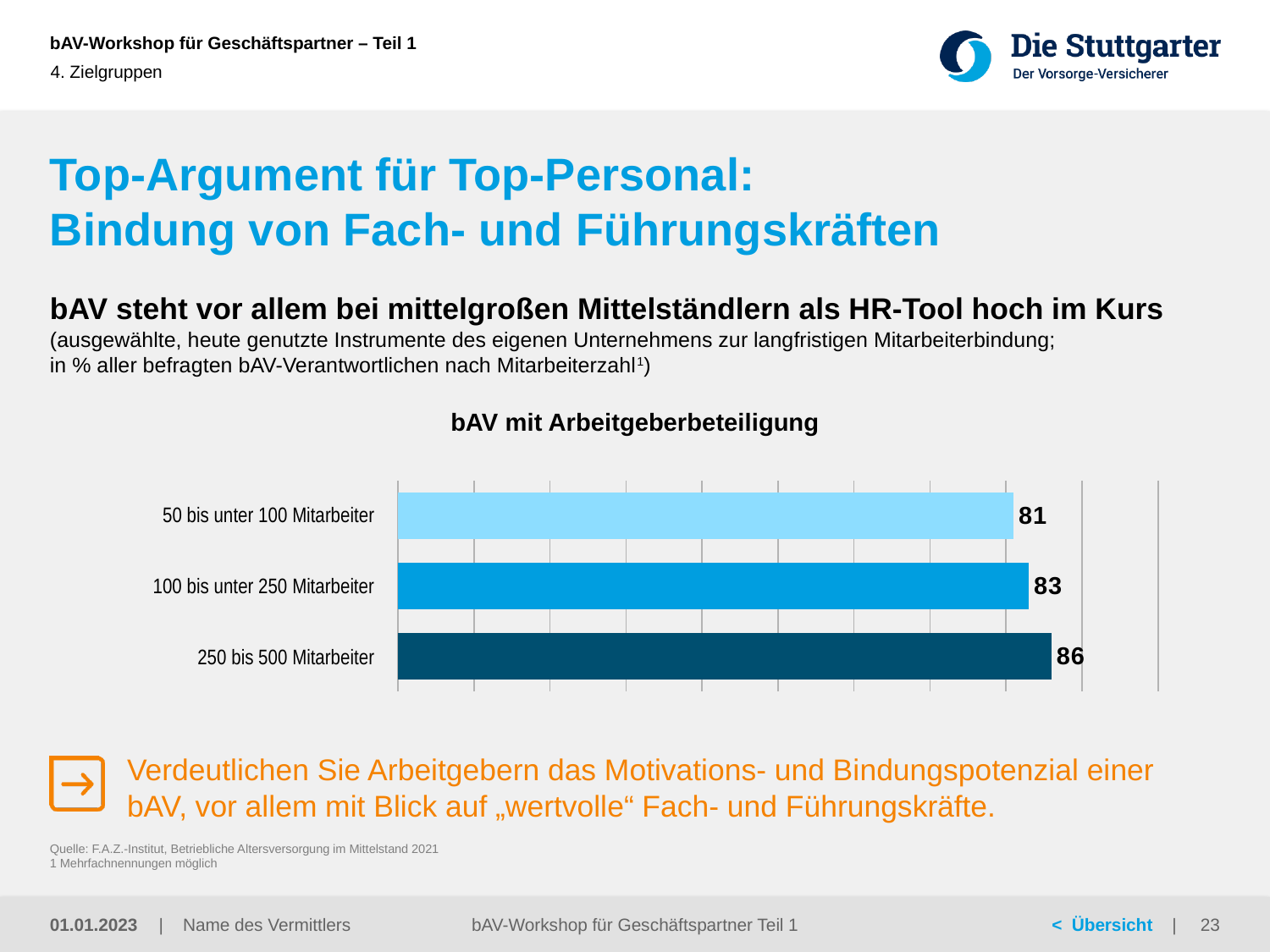
What is the difference between the values for "250 bis 500 Mitarbeiter" and "50 bis unter 100 Mitarbeiter"? 5 Which category has the highest value? 250 bis 500 Mitarbeiter What is the title of the chart? bAV mit Arbeitgeberbeteiligung What is the value for "250 bis 500 Mitarbeiter"? 86 How many categories are shown in the chart? 3 Which is larger: the value for "100 bis unter 250 Mitarbeiter" or for "250 bis 500 Mitarbeiter"? 250 bis 500 Mitarbeiter What is the value for "50 bis unter 100 Mitarbeiter"? 81 What is the value for "100 bis unter 250 Mitarbeiter"? 83 Do the values rise or fall as the company size category increases from top to bottom? Rise What kind of chart is shown on the slide? Bar chart Which category has the lowest value? 50 bis unter 100 Mitarbeiter What is the difference between the values for "100 bis unter 250 Mitarbeiter" and "50 bis unter 100 Mitarbeiter"? 2